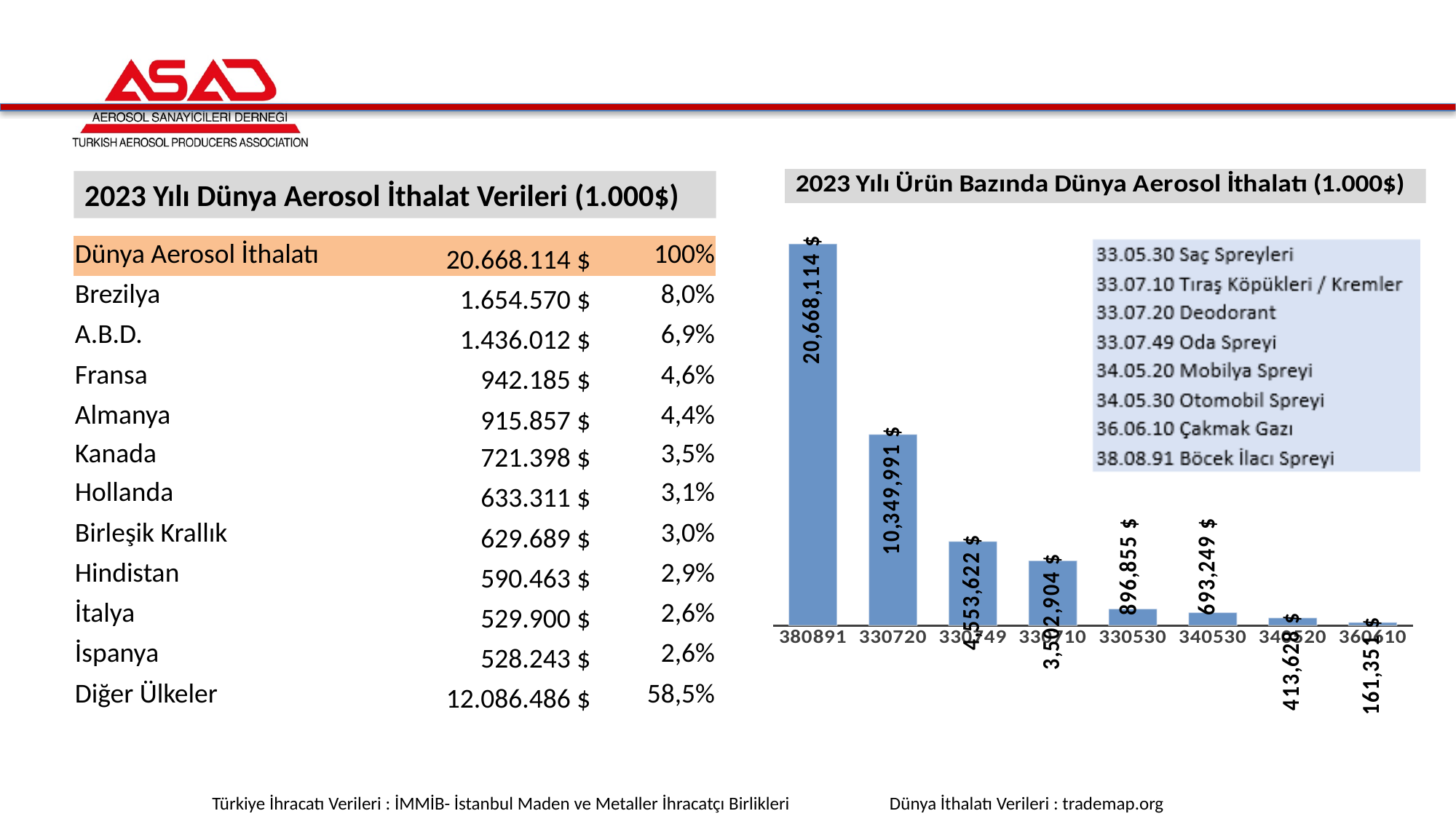
In the chart '2023 Yılı Ürün Bazında Dünya Aerosol İthalatı (1.000$)', which category has the highest value? 380891 In the chart '2023 Yılı Ürün Bazında Dünya Aerosol İthalatı (1.000$)', do the values rise or fall from left to right along the x axis? fall What type of chart is shown on the right side of the slide? bar chart In the chart '2023 Yılı Ürün Bazında Dünya Aerosol İthalatı (1.000$)', which category has the lowest value? 360610 In the chart '2023 Yılı Ürün Bazında Dünya Aerosol İthalatı (1.000$)', what is the difference between the values for 380891 and 330720? 10,318,123 $ In the chart '2023 Yılı Ürün Bazında Dünya Aerosol İthalatı (1.000$)', what is the difference between the values for 340520 and 360610? 252,277 $ In the chart '2023 Yılı Ürün Bazında Dünya Aerosol İthalatı (1.000$)', which is larger, the value for 330749 or the value for 330710? 330749 In the chart '2023 Yılı Ürün Bazında Dünya Aerosol İthalatı (1.000$)', what is the value for category 380891? 20,668,114 $ In the chart '2023 Yılı Ürün Bazında Dünya Aerosol İthalatı (1.000$)', what is the value for category 330720? 10,349,991 $ How many categories are shown on the x axis of the chart '2023 Yılı Ürün Bazında Dünya Aerosol İthalatı (1.000$)'? 8 In the chart '2023 Yılı Ürün Bazında Dünya Aerosol İthalatı (1.000$)', what is the value for category 360610? 161,351 $ In the chart '2023 Yılı Ürün Bazında Dünya Aerosol İthalatı (1.000$)', what is the value for category 330530? 896,855 $